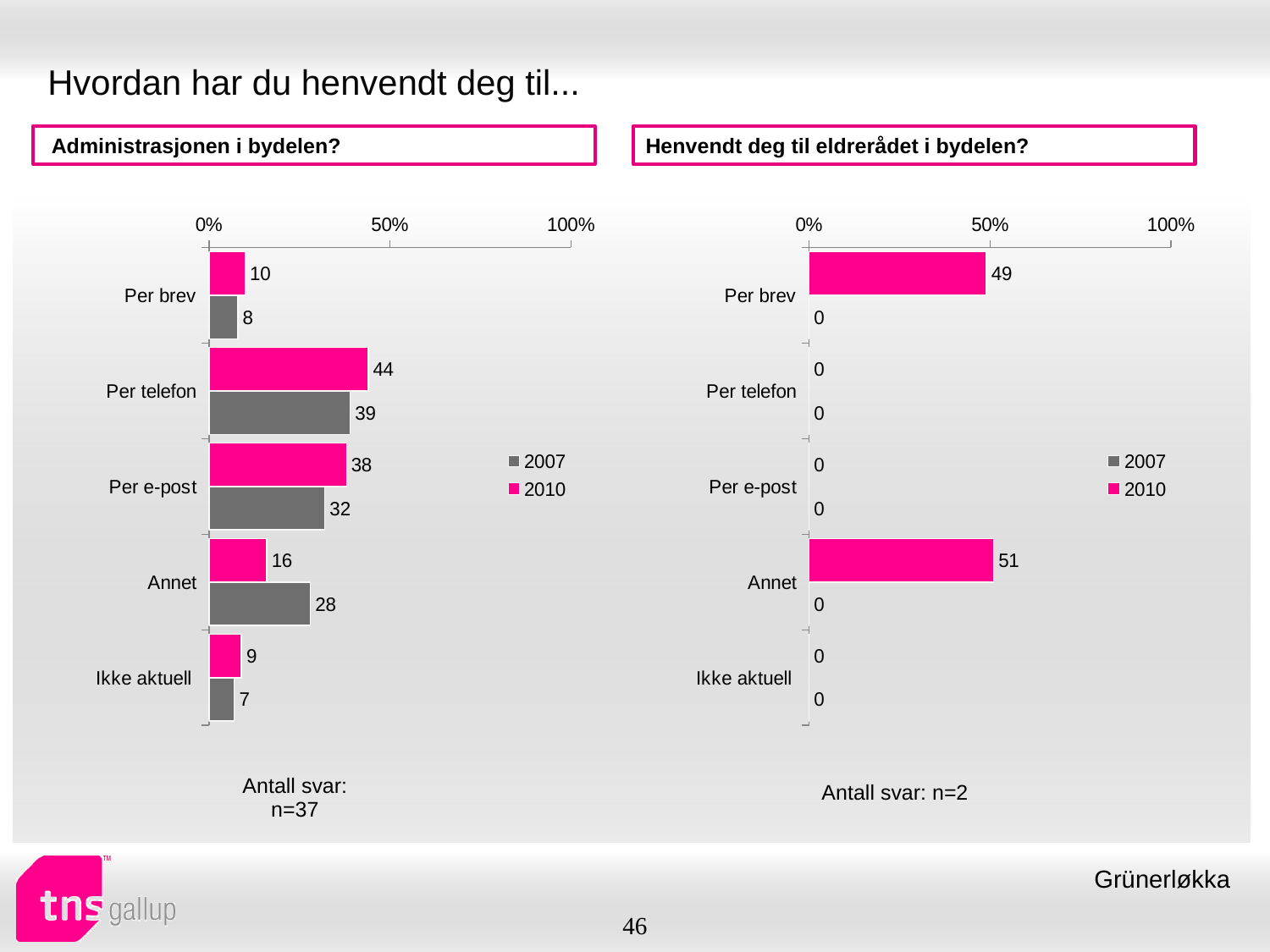
In the 'Administrasjonen i bydelen?' chart, which category has the highest value for 2010? Per telefon In the 'Administrasjonen i bydelen?' chart, what is the value for Per telefon in 2010? 44 What type of chart is the 'Administrasjonen i bydelen?' chart? Bar chart In the 'Administrasjonen i bydelen?' chart, which category has the lowest value for 2007? Ikke aktuell How many series does the legend list in the 'Henvendt deg til eldrerådet i bydelen?' chart? 2 In the 'Administrasjonen i bydelen?' chart, how many categories are shown? 5 In the 'Henvendt deg til eldrerådet i bydelen?' chart, what is the value for Per brev in 2010? 49 In the 'Administrasjonen i bydelen?' chart, what is the difference between the 2010 and 2007 values for Per e-post? 6 In the 'Henvendt deg til eldrerådet i bydelen?' chart, what is the value for Annet in 2010? 51 In the 'Administrasjonen i bydelen?' chart, what is the value for Annet in 2007? 28 In the 'Henvendt deg til eldrerådet i bydelen?' chart, which category has the highest value for 2010? Annet In the 'Administrasjonen i bydelen?' chart, which is larger for Annet: the 2007 value or the 2010 value? 2007